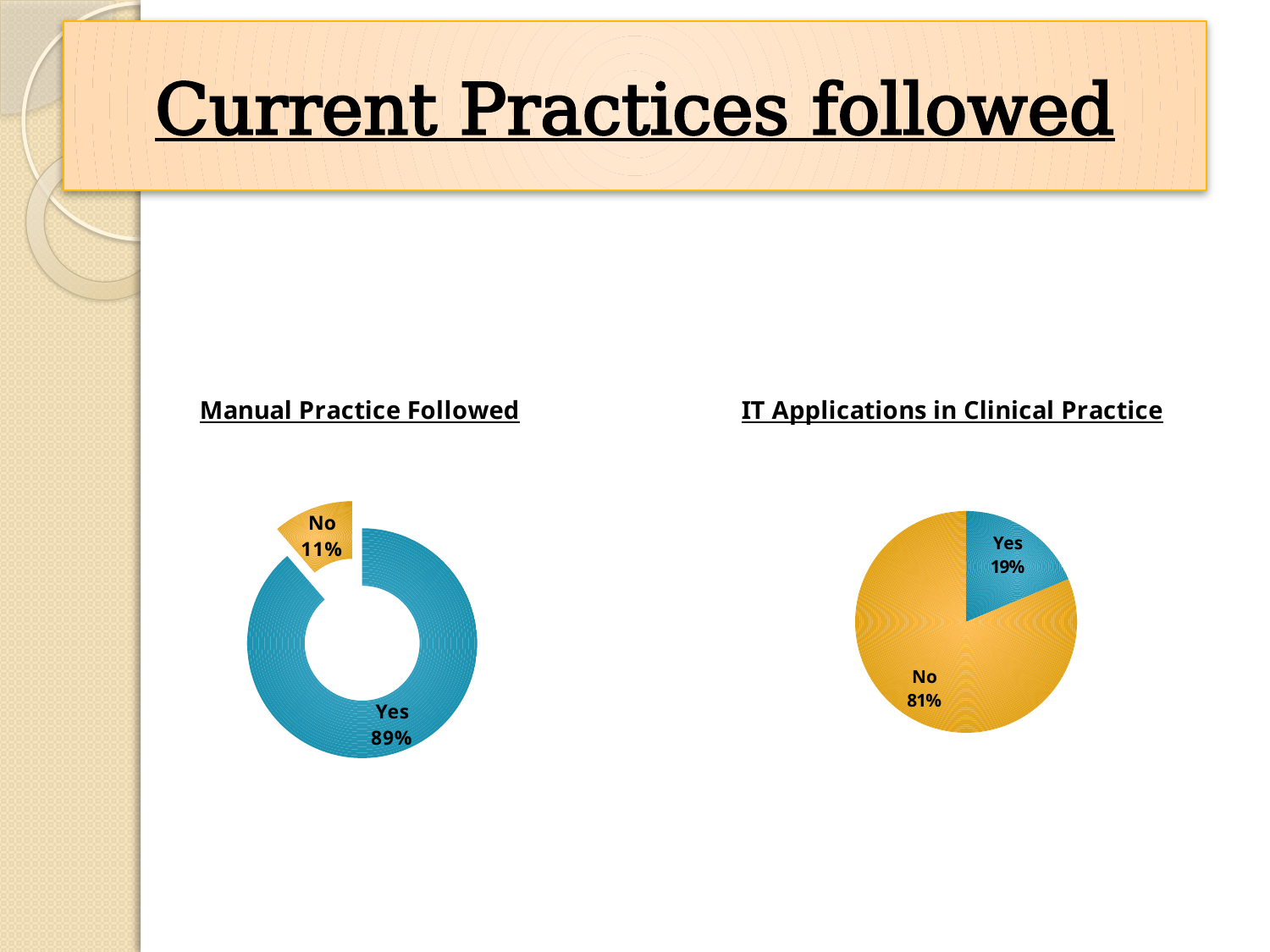
In the 'IT Applications in Clinical Practice' chart, what is the difference between the No and Yes percentages? 62% In the 'IT Applications in Clinical Practice' chart, which category has the smallest share? Yes In the 'Manual Practice Followed' chart, what percentage answered Yes? 89% In the 'Manual Practice Followed' chart, what is the difference between the Yes and No percentages? 78% In the 'Manual Practice Followed' chart, what percentage answered No? 11% What kind of chart is the 'Manual Practice Followed' chart? Doughnut chart In the 'Manual Practice Followed' chart, which category has the largest share? Yes Which is larger: the Yes share in the 'Manual Practice Followed' chart or the Yes share in the 'IT Applications in Clinical Practice' chart? Manual Practice Followed In the 'IT Applications in Clinical Practice' chart, what percentage answered No? 81% What is the title of the chart on the right side of the slide? IT Applications in Clinical Practice How many categories does the 'IT Applications in Clinical Practice' chart show? 2 In the 'IT Applications in Clinical Practice' chart, what percentage answered Yes? 19%